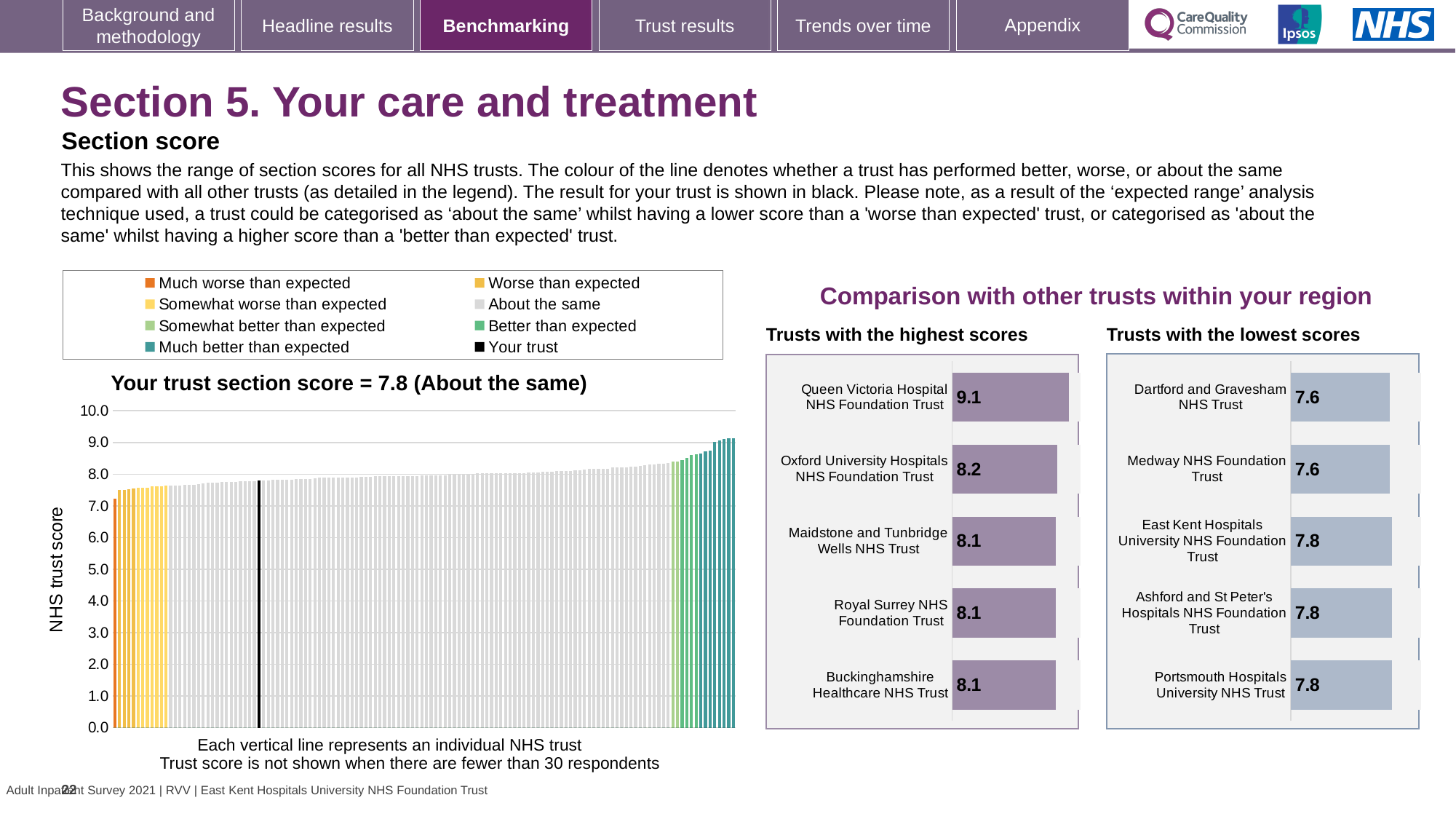
In the 'Your trust section score' chart, what is the section score for your trust? 7.8 In the 'Your trust section score' chart, which category is your trust placed in? About the same In the 'Trusts with the highest scores' chart, what is the difference between the scores of Queen Victoria Hospital NHS Foundation Trust and Oxford University Hospitals NHS Foundation Trust? 0.9 In the 'Trusts with the highest scores' chart, what is the score for Queen Victoria Hospital NHS Foundation Trust? 9.1 In the 'Your trust section score' chart, is the value of the leftmost (orange) bar greater or less than 8.0? less In the 'Your trust section score' chart, what is the label on the vertical axis? NHS trust score What kind of chart is the 'Your trust section score' chart? bar chart In the 'Trusts with the lowest scores' chart, what is the difference between the scores of Portsmouth Hospitals University NHS Trust and Dartford and Gravesham NHS Trust? 0.2 How many entries does the legend above the 'Your trust section score' chart list? 8 In the 'Trusts with the highest scores' chart, which trust has the highest score? Queen Victoria Hospital NHS Foundation Trust In the 'Trusts with the lowest scores' chart, what is the score for Medway NHS Foundation Trust? 7.6 How many trusts are shown in the 'Trusts with the lowest scores' chart? 5